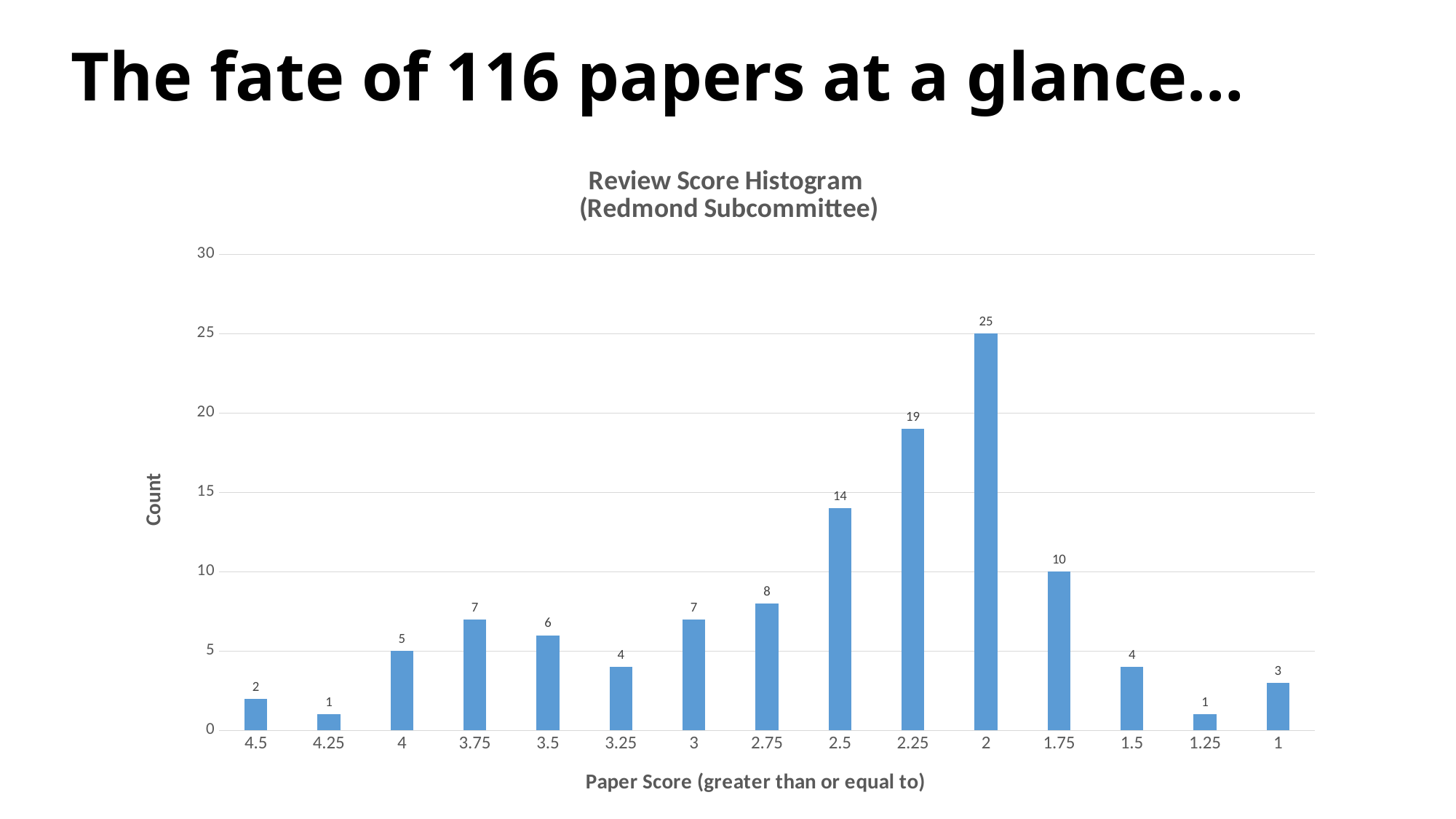
What is the count for a paper score of 3.75? 7 Which paper score has the highest count? 2 What is the title of the chart? Review Score Histogram (Redmond Subcommittee) What is the count for a paper score of 2? 25 Which has a larger count, paper score 1.75 or paper score 2.75? 1.75 What is the label of the y axis? Count What is the count for a paper score of 2.5? 14 Is the count for paper score 2.25 greater or less than 15? greater What kind of chart is shown on the slide? bar chart How many paper score categories are shown on the x axis? 15 Which paper scores have the lowest count? 4.25 and 1.25 What is the difference between the counts for paper scores 2 and 2.25? 6